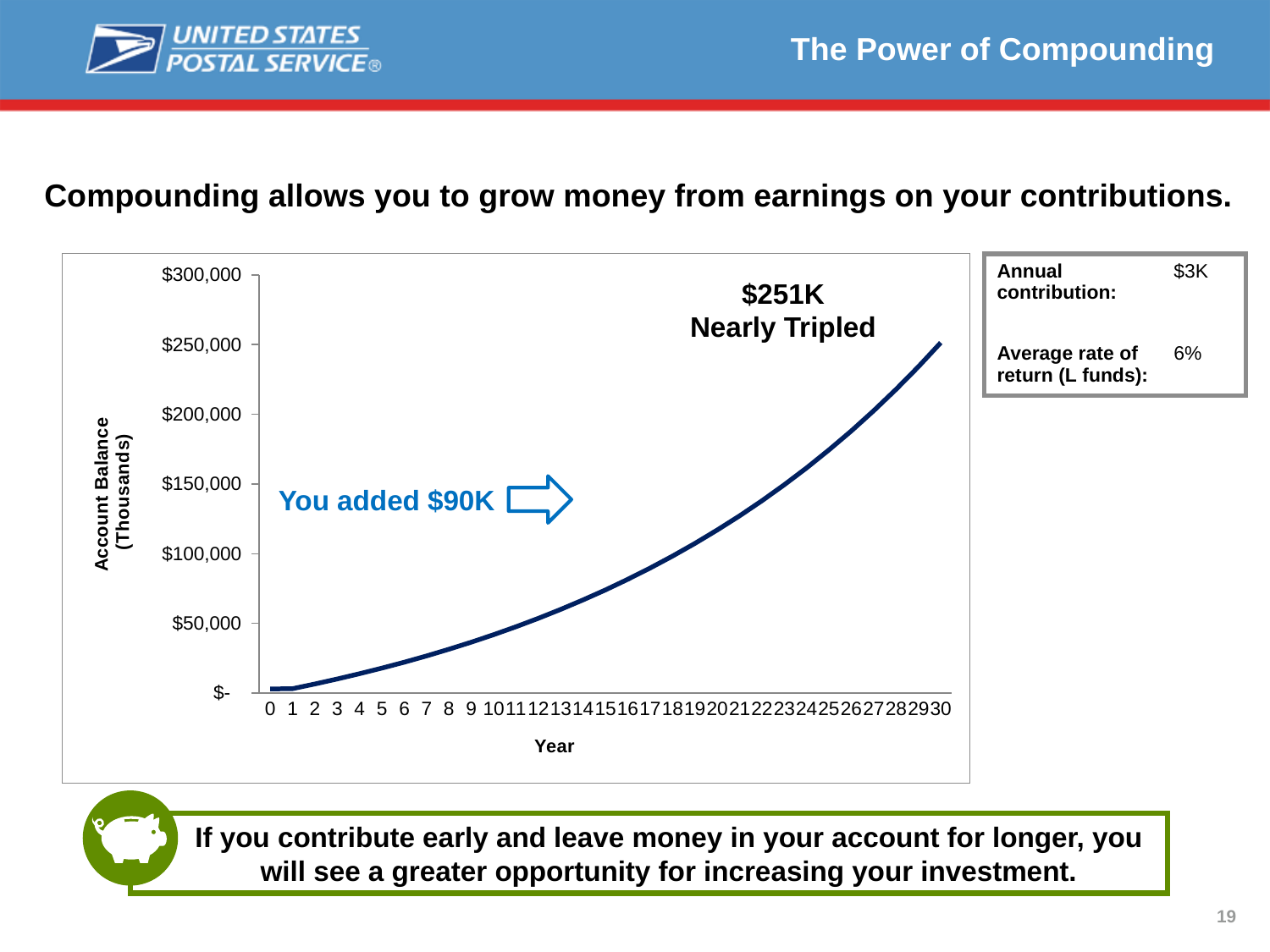
Is the account balance at year 30 greater or less than $200,000? greater Is the account balance at year 25 greater or less than $150,000? greater What is the title of the chart's y axis? Account Balance (Thousands) What account balance is labeled on the chart at the end of the 30-year period? $251K Does the account balance rise or fall as the years increase along the x axis? rise Is the account balance at year 15 greater or less than $100,000? less At which year is the account balance highest? 30 At which year is the account balance lowest? 0 Which has the larger account balance, year 10 or year 30? year 30 What annual contribution amount is stated in the box next to the chart? $3K What kind of chart is shown on the slide? line chart